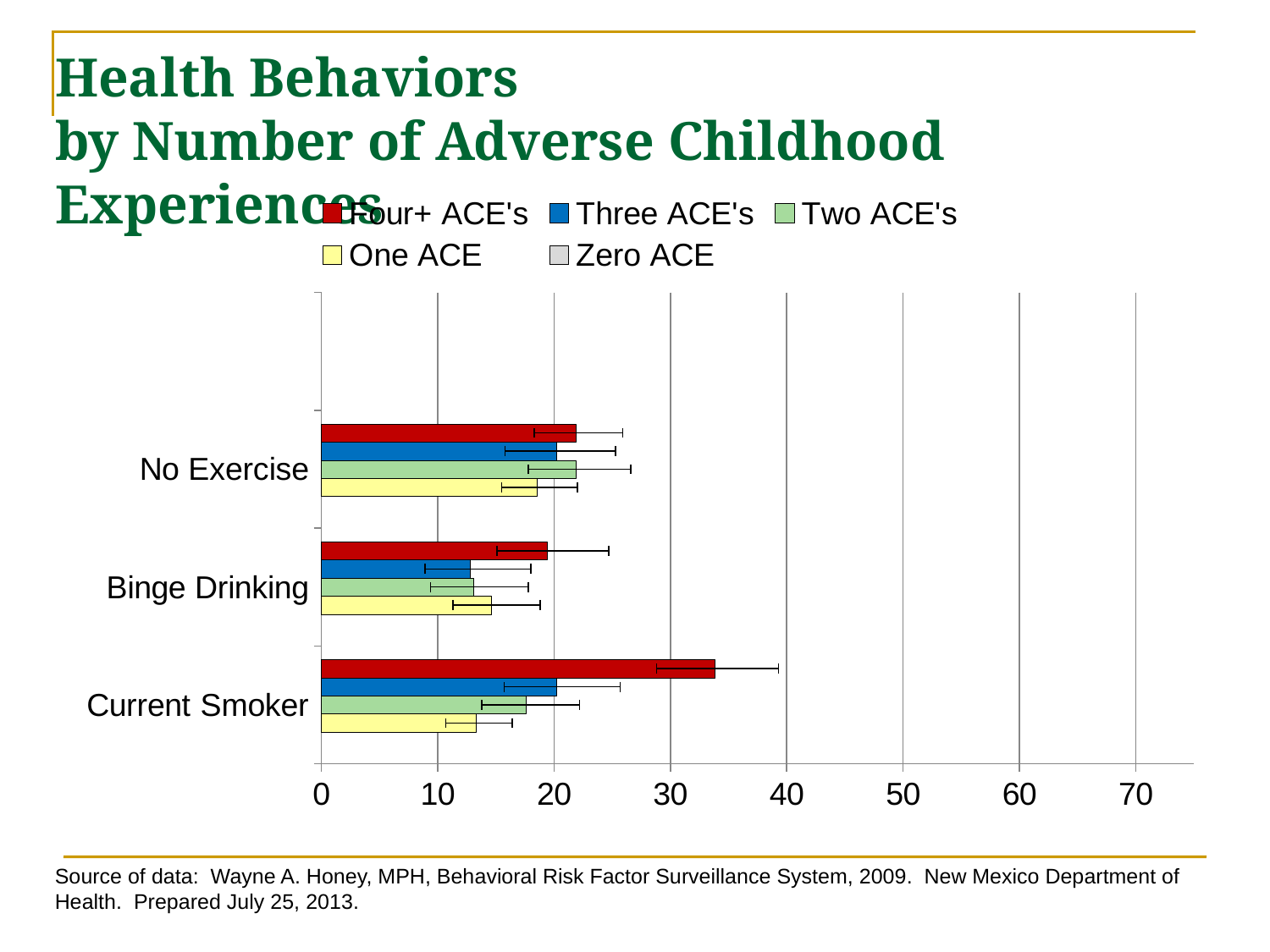
Is the Three ACE's value for Binge Drinking greater or less than 20? less How many health behavior categories are shown on the chart's vertical axis? 3 Which health behavior has the highest Four+ ACE's value? Current Smoker Is the One ACE value for Current Smoker greater or less than 20? less Which health behavior has the lowest Three ACE's value? Binge Drinking What kind of chart is shown on the slide? Bar chart Is the Four+ ACE's value for Current Smoker greater or less than 30? greater How many series does the chart's legend list? 5 For Binge Drinking, which is larger: the Four+ ACE's value or the Three ACE's value? Four+ ACE's For Current Smoker, which is larger: the Four+ ACE's value or the Three ACE's value? Four+ ACE's What colour represents the Four+ ACE's series in the legend? Red